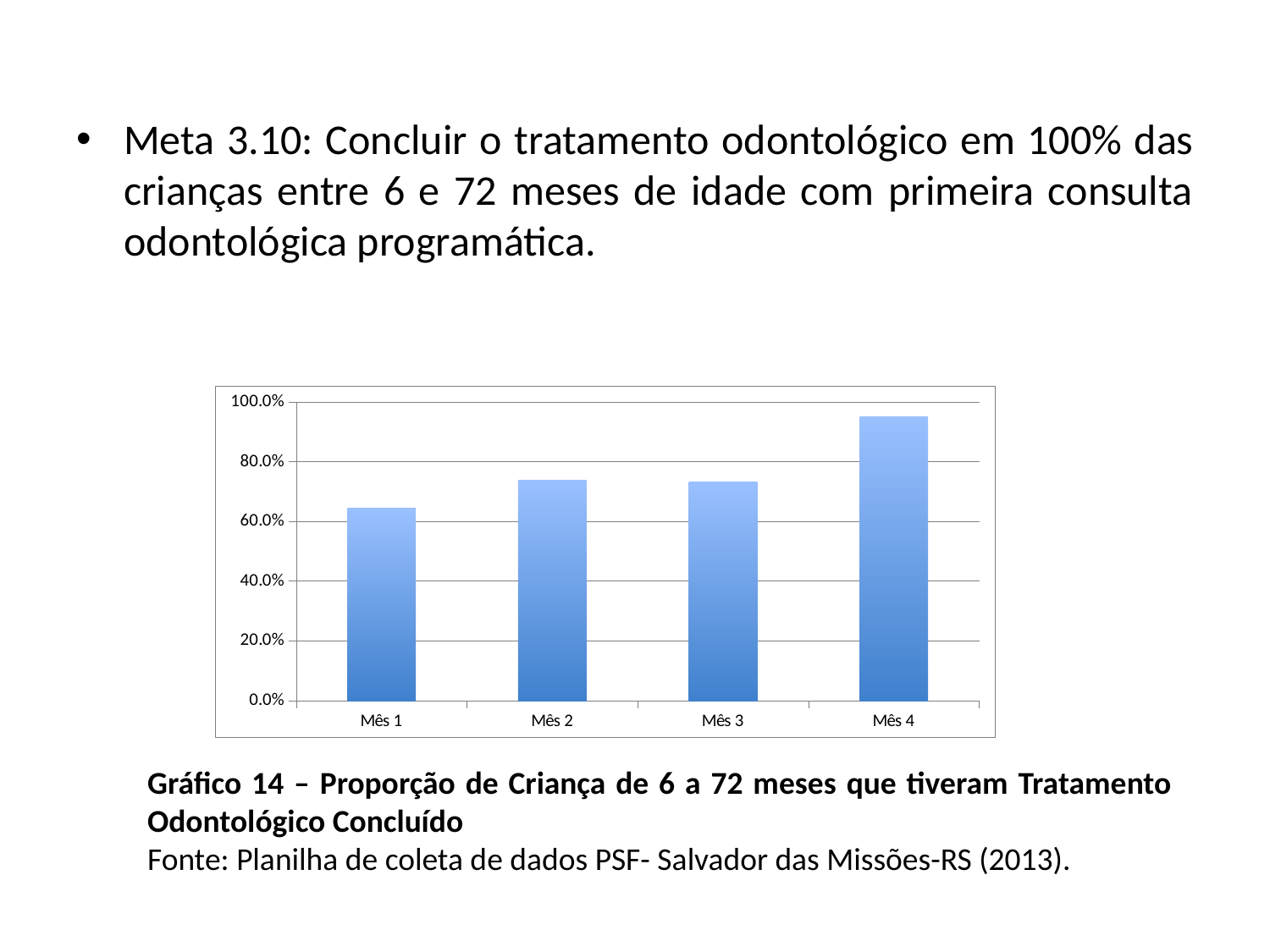
Which is larger, the value for Mês 2 or the value for Mês 1? Mês 2 Which month has the highest value on the chart? Mês 4 Is the value for Mês 2 greater or less than 80.0%? less How many categories (months) are plotted on the chart? 4 What is the label of the first category on the x axis? Mês 1 Is the value for Mês 3 greater or less than 60.0%? greater Which month has the lowest value on the chart? Mês 1 Is the value for Mês 4 greater or less than 80.0%? greater Which is larger, the value for Mês 4 or the value for Mês 1? Mês 4 What kind of chart is shown on the slide? Bar chart